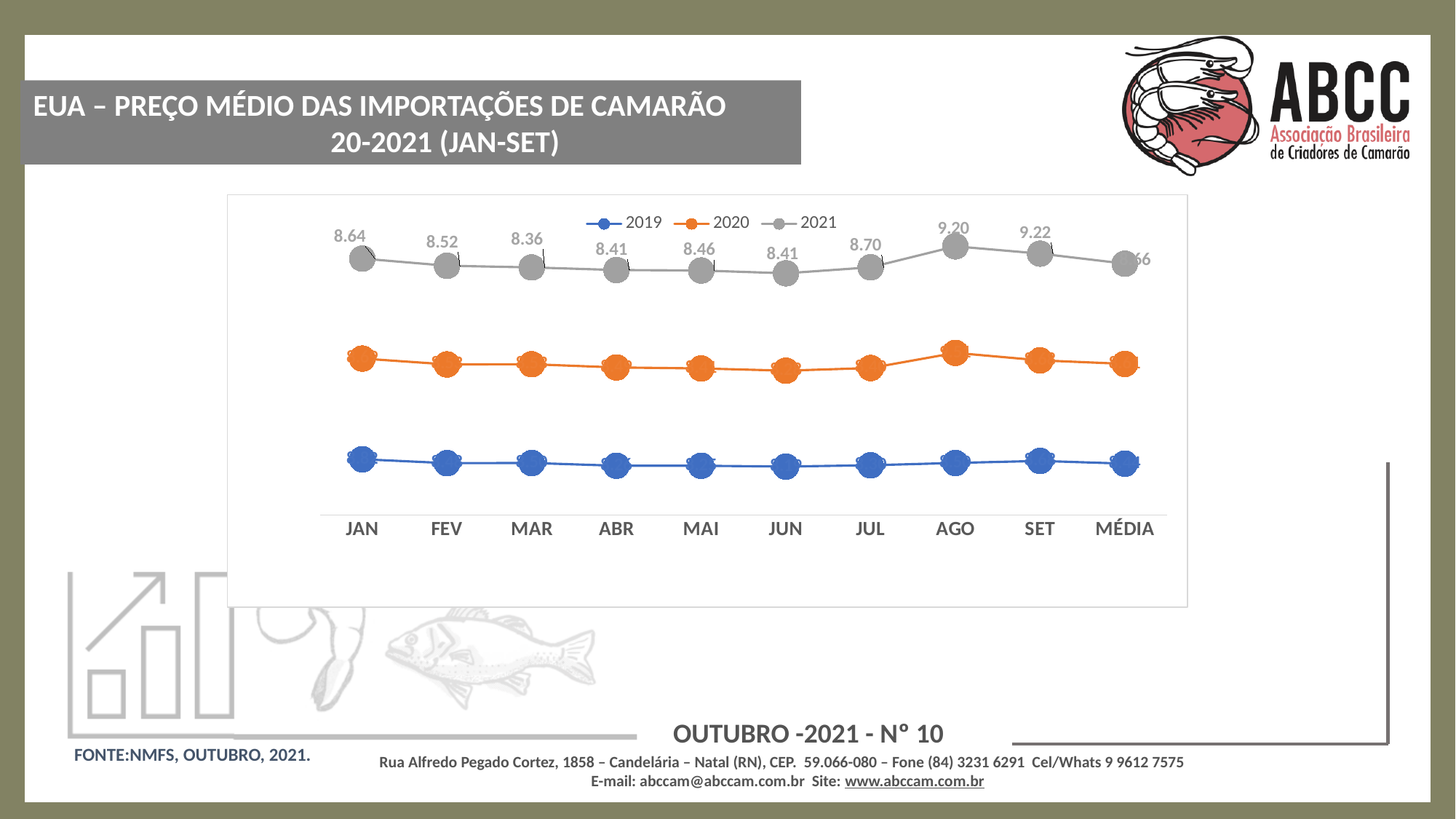
How many series does the legend list? 3 What is the value for 2021 in JAN? 8.64 What is the difference between the 2021 values for SET and JAN? 0.58 What is the value for 2021 in MAR? 8.36 In which month is the 2021 value highest? SET What type of chart is shown on the slide? Line chart What is the value for 2021 in AGO? 9.20 How many categories are shown on the x axis? 10 Does the 2021 line rise or fall from JUN to SET? Rise In which month is the 2021 value lowest? MAR Which series is drawn in orange? 2020